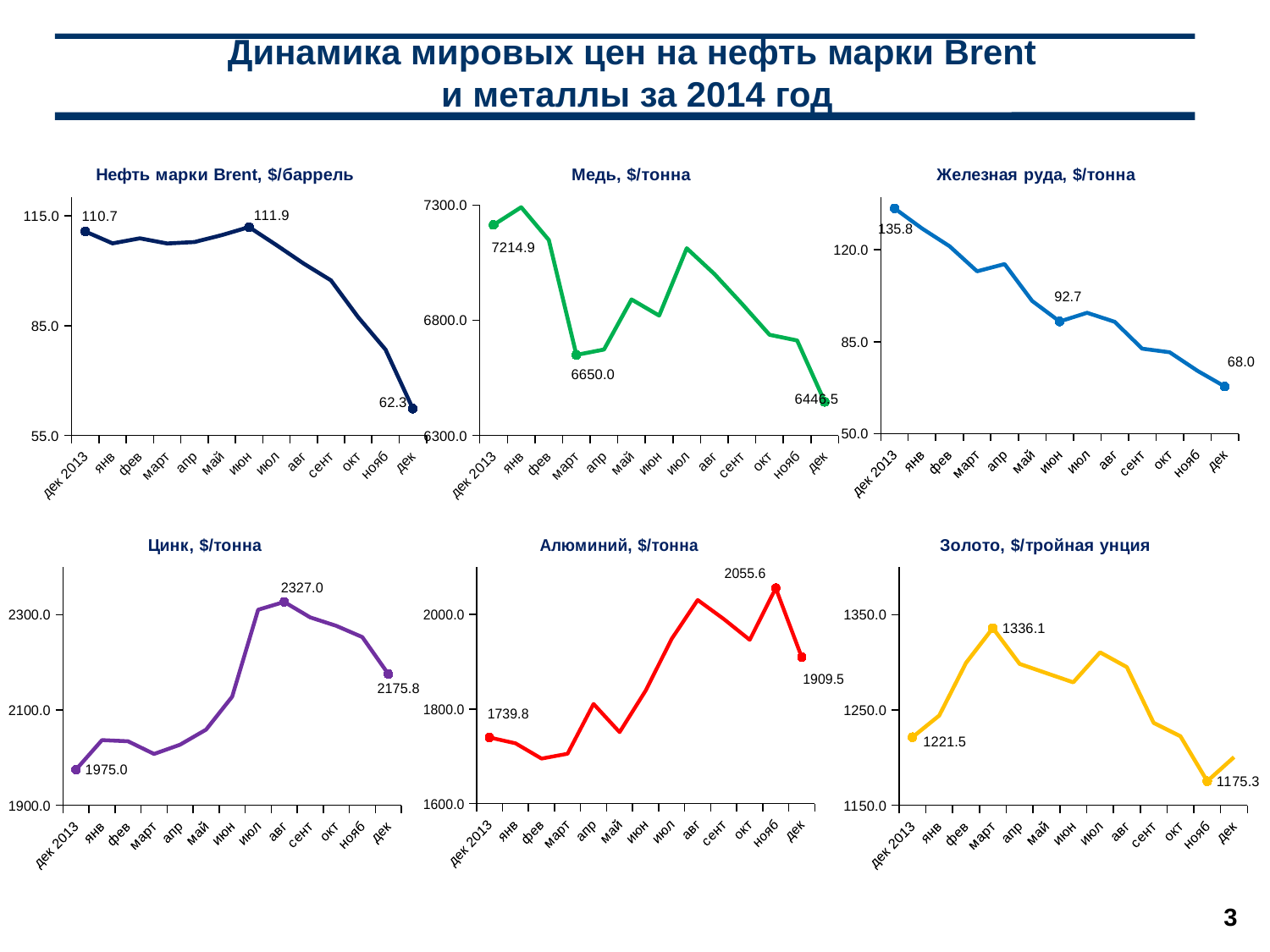
On the 'Алюминий, $/тонна' chart, which is larger: the value for нояб or the value for дек? нояб On the 'Цинк, $/тонна' chart, what is the value labelled for авг? 2327.0 On the 'Медь, $/тонна' chart, what is the value labelled for март? 6650.0 On the 'Железная руда, $/тонна' chart, what is the difference between the дек 2013 value and the дек value? 67.8 What type of chart is the 'Алюминий, $/тонна' chart? line chart How many data points are plotted on the 'Медь, $/тонна' chart? 13 On the 'Цинк, $/тонна' chart, is the value for апр greater or less than 2100.0? less On the 'Нефть марки Brent, $/баррель' chart, what is the value for дек (2014)? 62.3 On the 'Нефть марки Brent, $/баррель' chart, what is the value for дек 2013? 110.7 How many charts are shown on the slide? 6 On the 'Золото, $/тройная унция' chart, what is the value labelled for нояб? 1175.3 On the 'Железная руда, $/тонна' chart, do the values generally rise or fall from дек 2013 to дек? fall